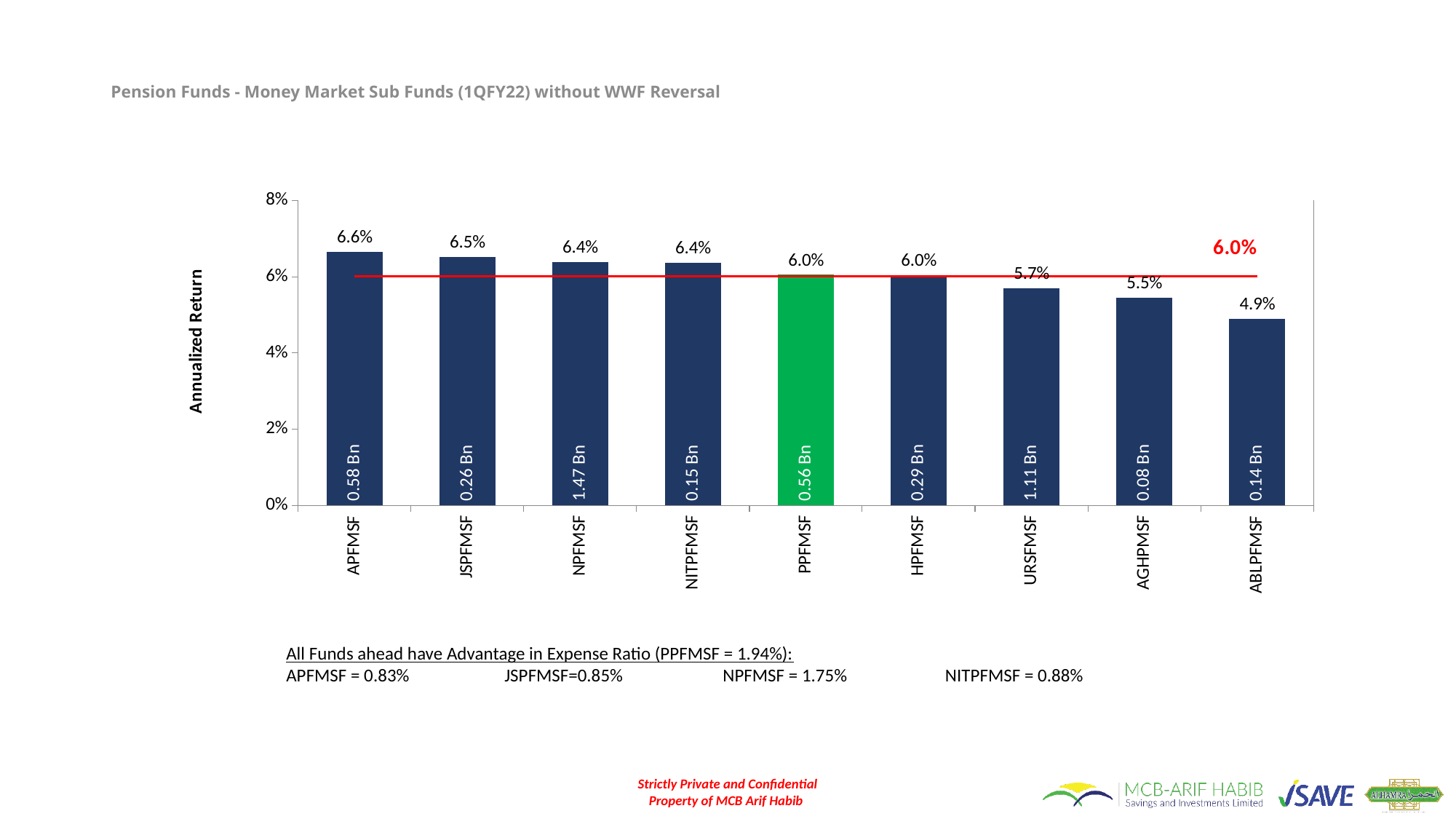
Which has a higher annualized return, JSPFMSF or AGHPMSF? JSPFMSF Which fund's bar is coloured green? PPFMSF What type of chart is shown on the slide? Bar chart What is the annualized return for URSFMSF? 5.7% What is the annualized return for ABLPFMSF? 4.9% Which fund has the lowest annualized return? ABLPFMSF What fund size is printed inside the NPFMSF bar? 1.47 Bn Is the annualized return for AGHPMSF greater or less than 6%? less What is the annualized return for APFMSF? 6.6% Which fund has the highest annualized return? APFMSF What is the difference between the annualized returns of APFMSF and ABLPFMSF? 1.7% How many funds are shown in the chart? 9